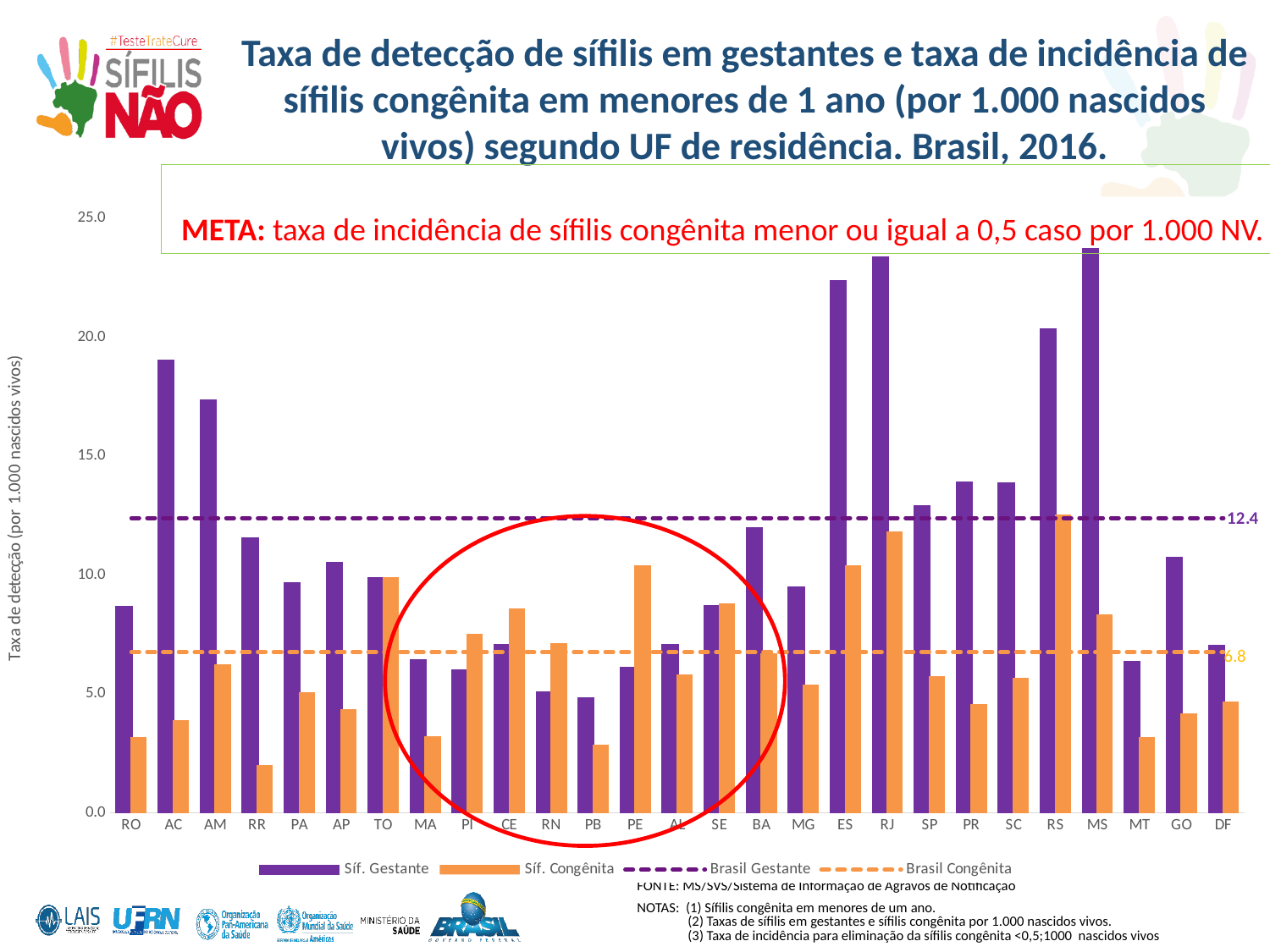
Which UF has the highest 'Síf. Congênita' bar? RS What value is labelled on the dashed 'Brasil Congênita' reference line? 6.8 For PE, which is larger, the 'Síf. Gestante' bar or the 'Síf. Congênita' bar? Síf. Congênita How many entries does the chart legend list? 4 Which UF has the lowest 'Síf. Congênita' bar? RR How many UF categories are shown along the x axis of the chart? 27 Is the 'Síf. Gestante' value for ES greater or less than 20.0? greater What kind of chart is shown on the slide? bar chart Which is larger, the 'Síf. Gestante' value for AC or for AM? AC Is the 'Síf. Gestante' value for MT greater or less than 10.0? less Is the 'Síf. Gestante' value for AC greater or less than 15.0? greater What value is labelled on the dashed 'Brasil Gestante' reference line? 12.4